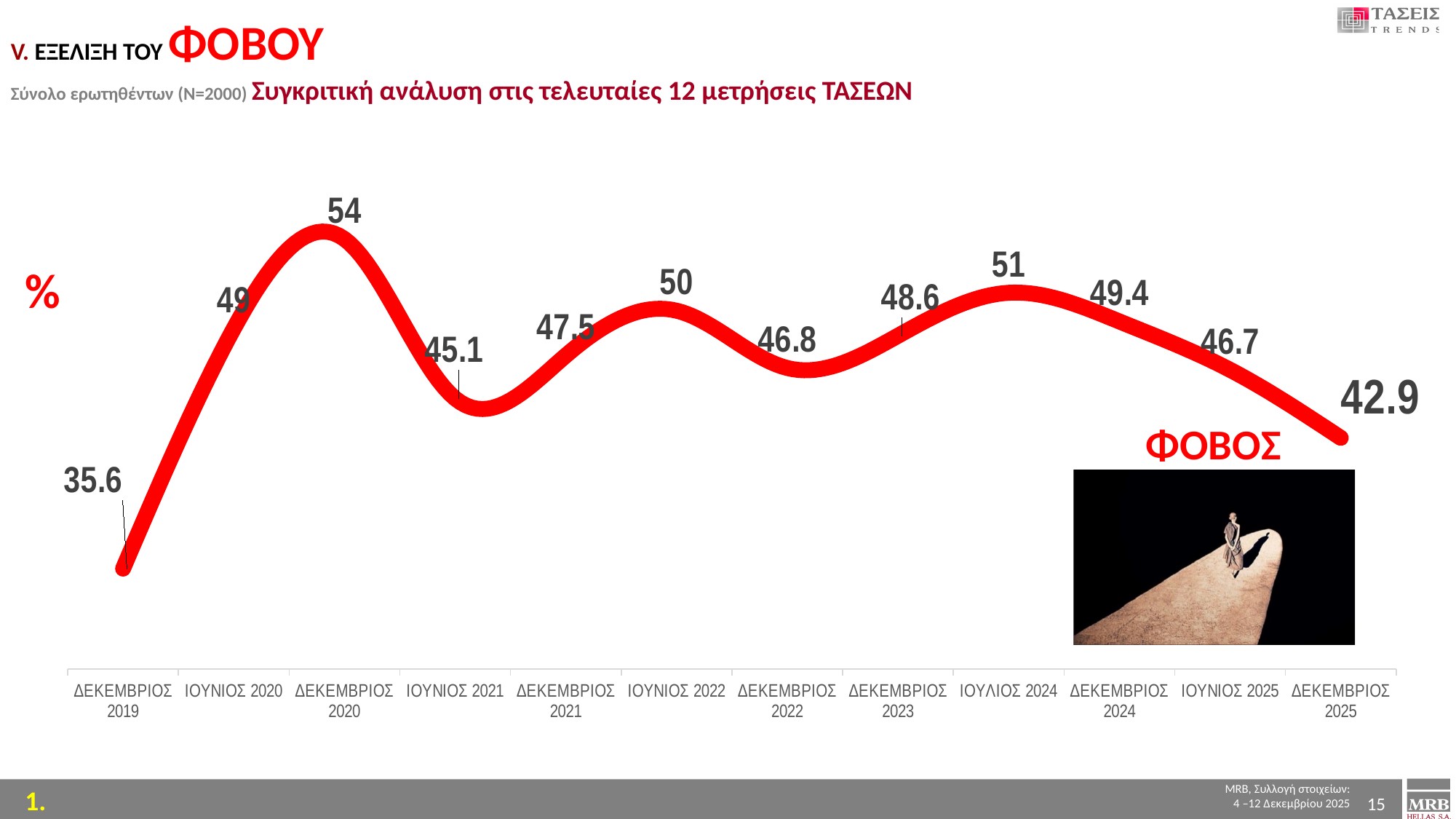
Does the value rise or fall from ΙΟΥΛΙΟΣ 2024 to ΔΕΚΕΜΒΡΙΟΣ 2025? Fall What colour is the line on the chart? Red What is the value for ΙΟΥΛΙΟΣ 2024? 51 What is the value for ΔΕΚΕΜΒΡΙΟΣ 2025? 42.9 What is the value for ΔΕΚΕΜΒΡΙΟΣ 2019? 35.6 What is the difference between the values for ΙΟΥΝΙΟΣ 2025 and ΔΕΚΕΜΒΡΙΟΣ 2025? 3.8 What is the difference between the values for ΔΕΚΕΜΒΡΙΟΣ 2020 and ΔΕΚΕΜΒΡΙΟΣ 2025? 11.1 Which measurement has the lowest value? ΔΕΚΕΜΒΡΙΟΣ 2019 What type of chart is shown on the slide? Line chart Which measurement has the highest value? ΔΕΚΕΜΒΡΙΟΣ 2020 Which is larger, the value for ΙΟΥΝΙΟΣ 2022 or the value for ΔΕΚΕΜΒΡΙΟΣ 2022? ΙΟΥΝΙΟΣ 2022 How many measurement points are plotted on the chart? 12